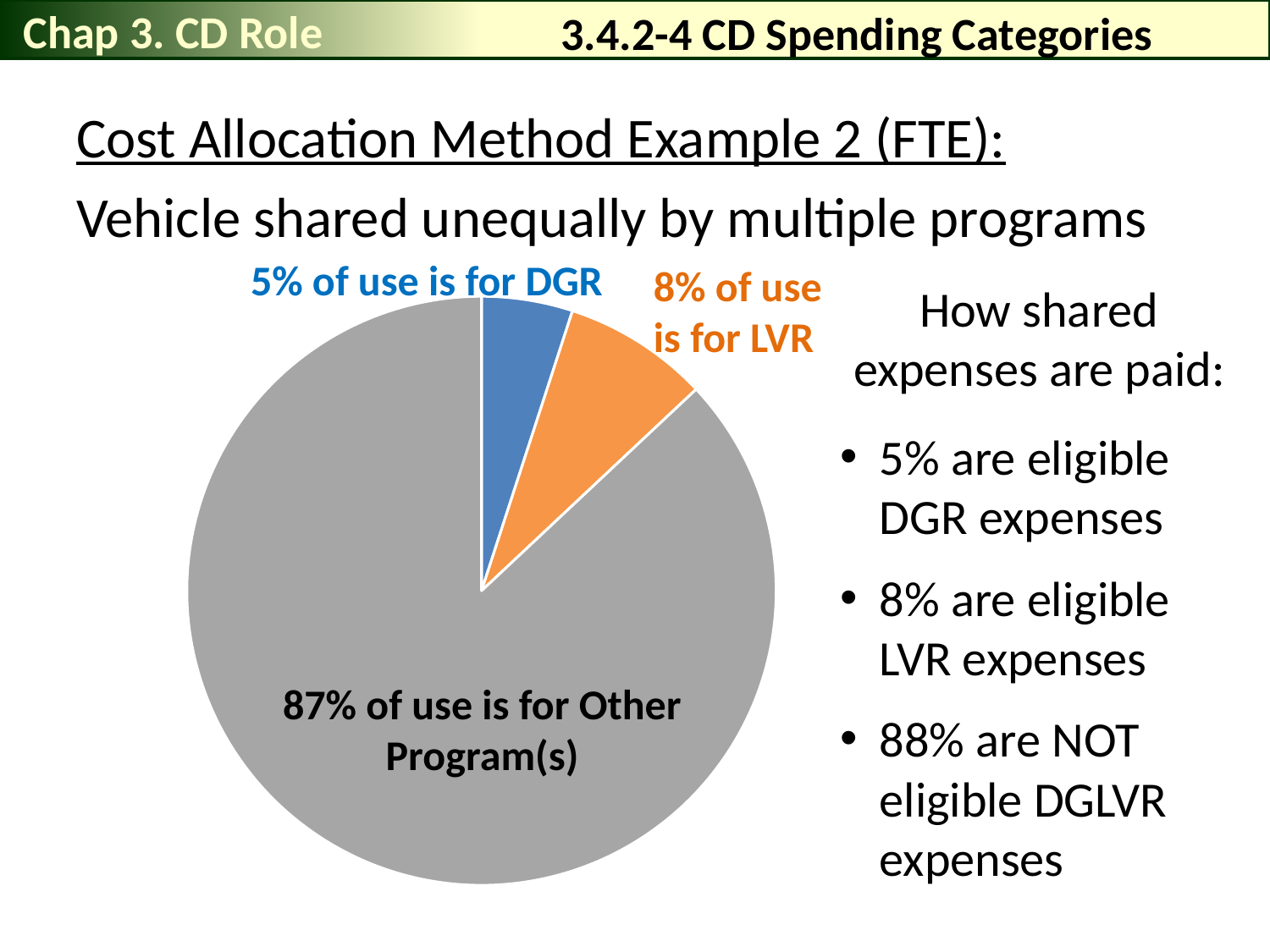
What is the difference between the share of use for Other Program(s) and the share of use for LVR? 79% What kind of chart is shown on the slide? pie chart Which slice of the pie chart is the smallest? DGR What is the difference between the share of use for LVR and the share of use for DGR? 3% Which slice of the pie chart is the largest? Other Program(s) What share of vehicle use is for LVR according to the pie chart? 8% What colour is the slice representing use for Other Program(s)? gray Which is larger in the pie chart, the share for DGR or the share for LVR? LVR What share of vehicle use is for Other Program(s) according to the pie chart? 87% What share of vehicle use is for DGR according to the pie chart? 5% What colour is the slice representing use for DGR? blue How many slices does the pie chart have? 3